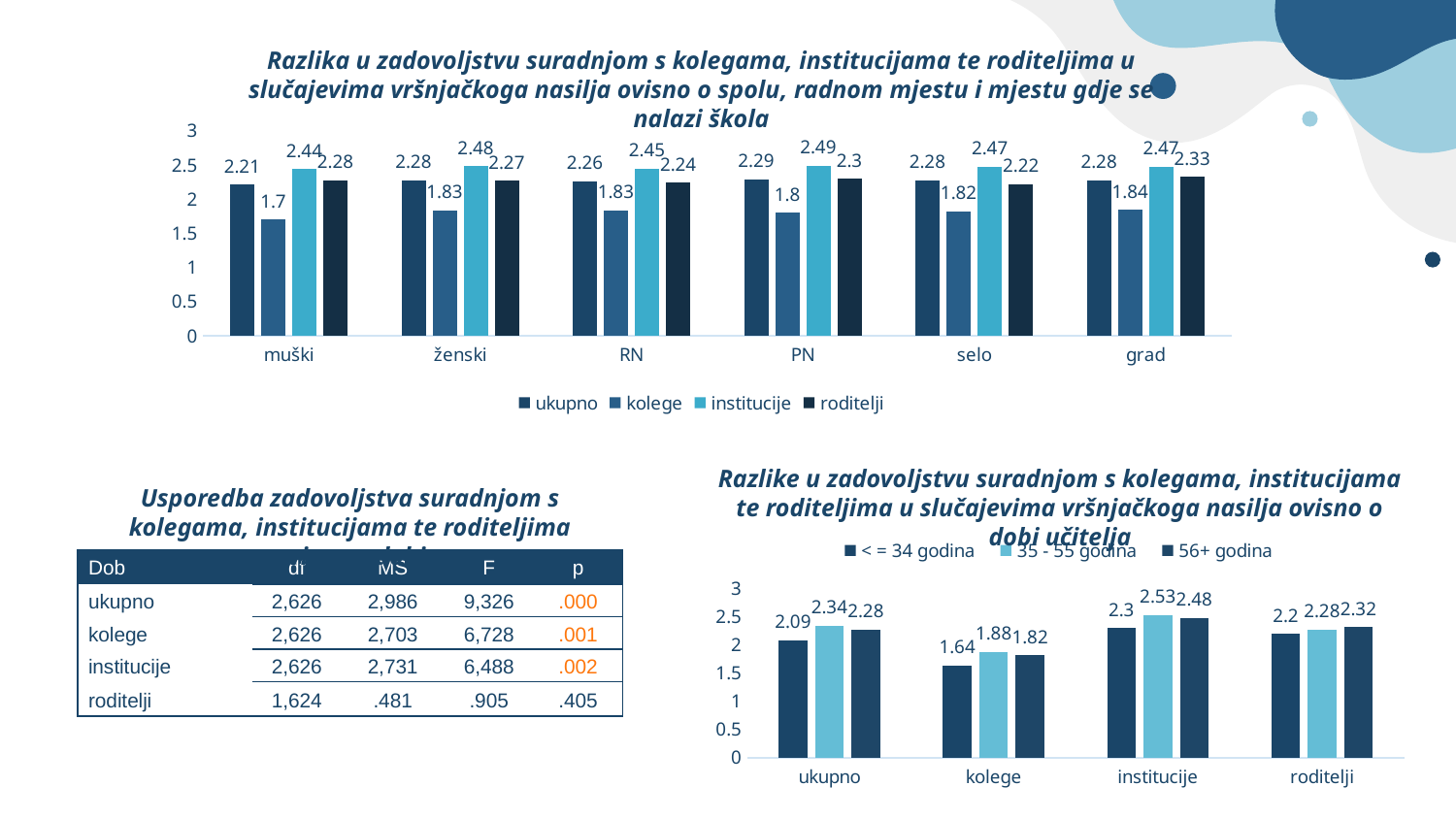
What kind of chart is the bottom-right chart? bar chart In the bottom-right chart, what is the value for 35 - 55 godina in the institucije category? 2.53 In the top chart, what is the value for institucije in the PN category? 2.49 In the bottom-right chart, which category has the lowest value for 56+ godina? kolege In the top chart, what is the value for kolege in the muški category? 1.7 In the top chart, how many series does the legend list? 4 In the top chart, which series has the lowest value in the ženski category? kolege In the top chart, how many categories are shown on the x axis? 6 In the bottom-right chart, what is the value for < = 34 godina in the kolege category? 1.64 In the top chart, what is the difference between institucije and kolege in the grad category? 0.63 In the bottom-right chart, which is larger in the ukupno category: < = 34 godina or 35 - 55 godina? 35 - 55 godina In the top chart, is the value for roditelji in the selo category greater or less than 2? greater